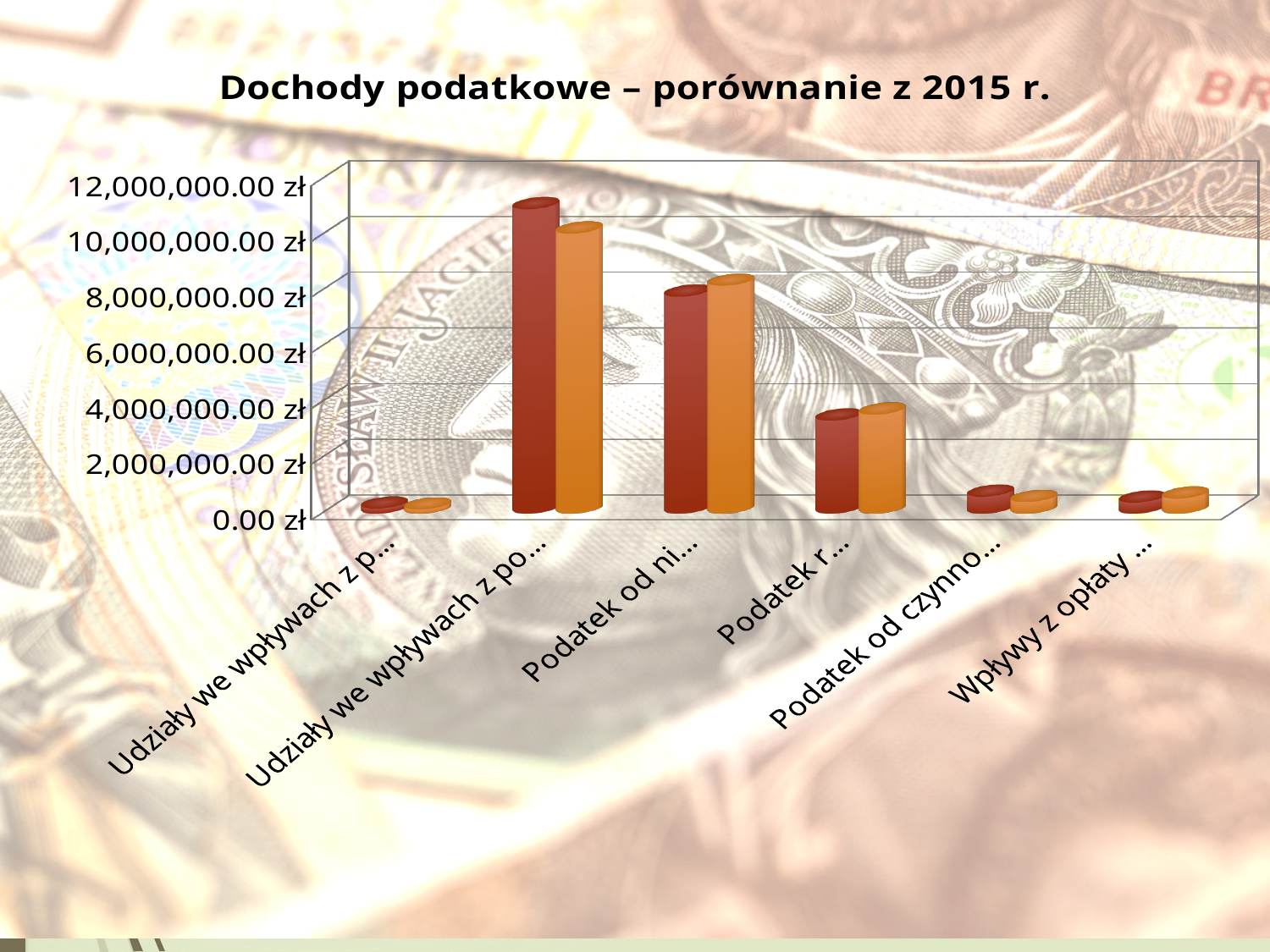
Is the orange bar for the fifth category from the left (Podatek od czynno...) greater or less than 2,000,000.00 zł? less Which category has the tallest bars in the chart? The second category from the left (Udziały we wpływach z po...) Which category has the shortest bars in the chart? The first category from the left (Udziały we wpływach z p...) What is the highest value labelled on the vertical axis of the chart? 12,000,000.00 zł What is the title of the chart? Dochody podatkowe – porównanie z 2015 r. In the third category from the left (Podatek od ni...), which bar is taller, the dark red one or the orange one? The orange one How many bars are plotted for each category in the chart? 2 Is the dark red bar for the fourth category from the left (Podatek r...) greater or less than 4,000,000.00 zł? less In the second category from the left, which bar is taller, the dark red one or the orange one? The dark red one What kind of chart is shown on the slide? Bar chart Is the dark red bar for the second category from the left greater or less than 10,000,000.00 zł? greater How many categories are shown on the x axis of the chart? 6